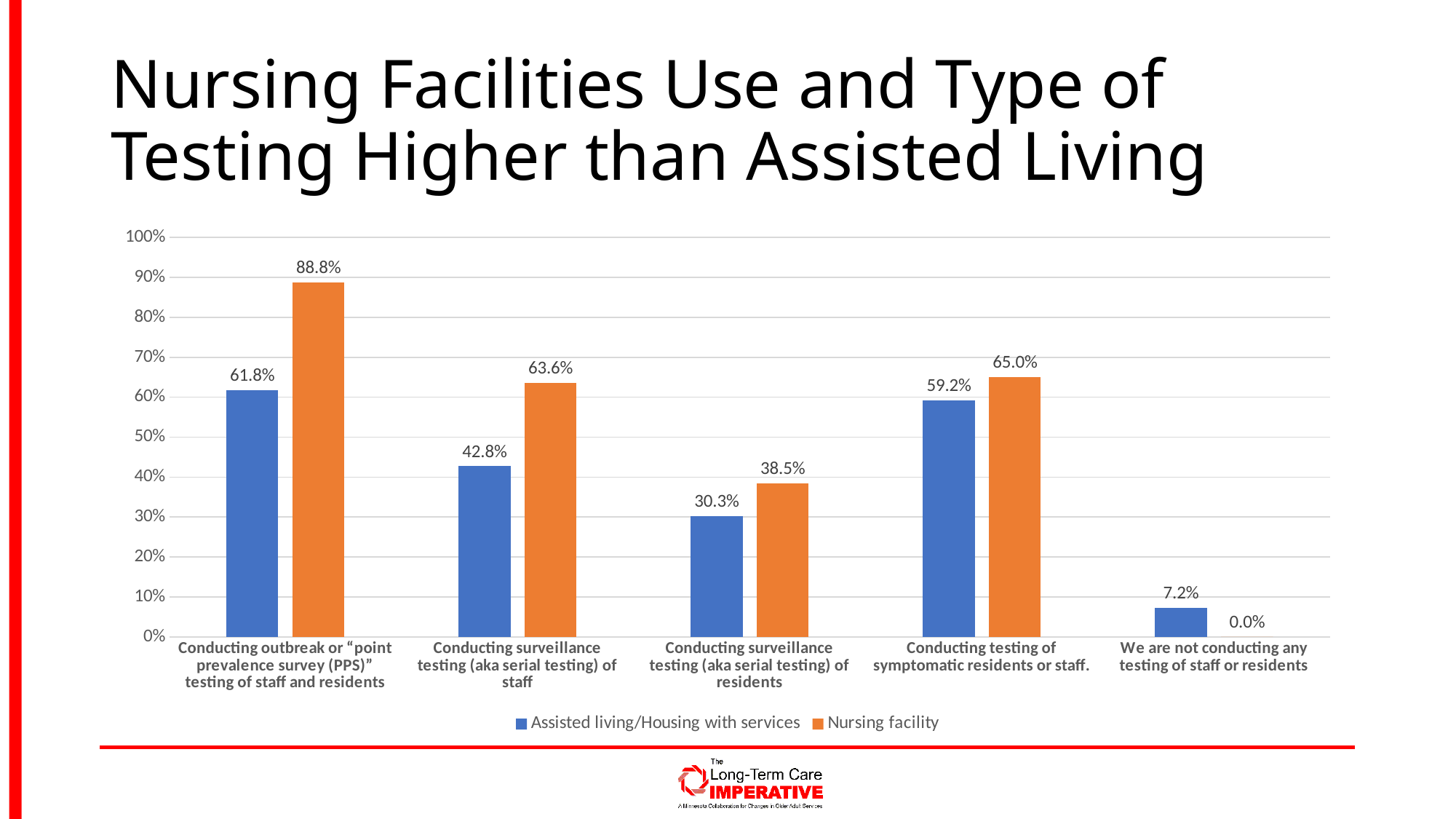
What is the Assisted living/Housing with services value for "We are not conducting any testing of staff or residents"? 7.2% What is the Assisted living/Housing with services value for "Conducting surveillance testing (aka serial testing) of staff"? 42.8% Which category has the lowest Assisted living/Housing with services value? We are not conducting any testing of staff or residents Which category has the highest Nursing facility value? Conducting outbreak or "point prevalence survey (PPS)" testing of staff and residents How many categories are shown on the x axis? 5 How many series does the legend list? 2 What is the Nursing facility value for "Conducting outbreak or "point prevalence survey (PPS)" testing of staff and residents"? 88.8% For "Conducting testing of symptomatic residents or staff.", which series has the larger value: Assisted living/Housing with services or Nursing facility? Nursing facility What kind of chart is shown on the slide? bar chart Is the Assisted living/Housing with services value for "Conducting surveillance testing (aka serial testing) of residents" greater or less than 40%? less What is the difference between the Nursing facility and Assisted living/Housing with services values for "Conducting outbreak or "point prevalence survey (PPS)" testing of staff and residents"? 27.0% What is the Nursing facility value for "Conducting surveillance testing (aka serial testing) of residents"? 38.5%